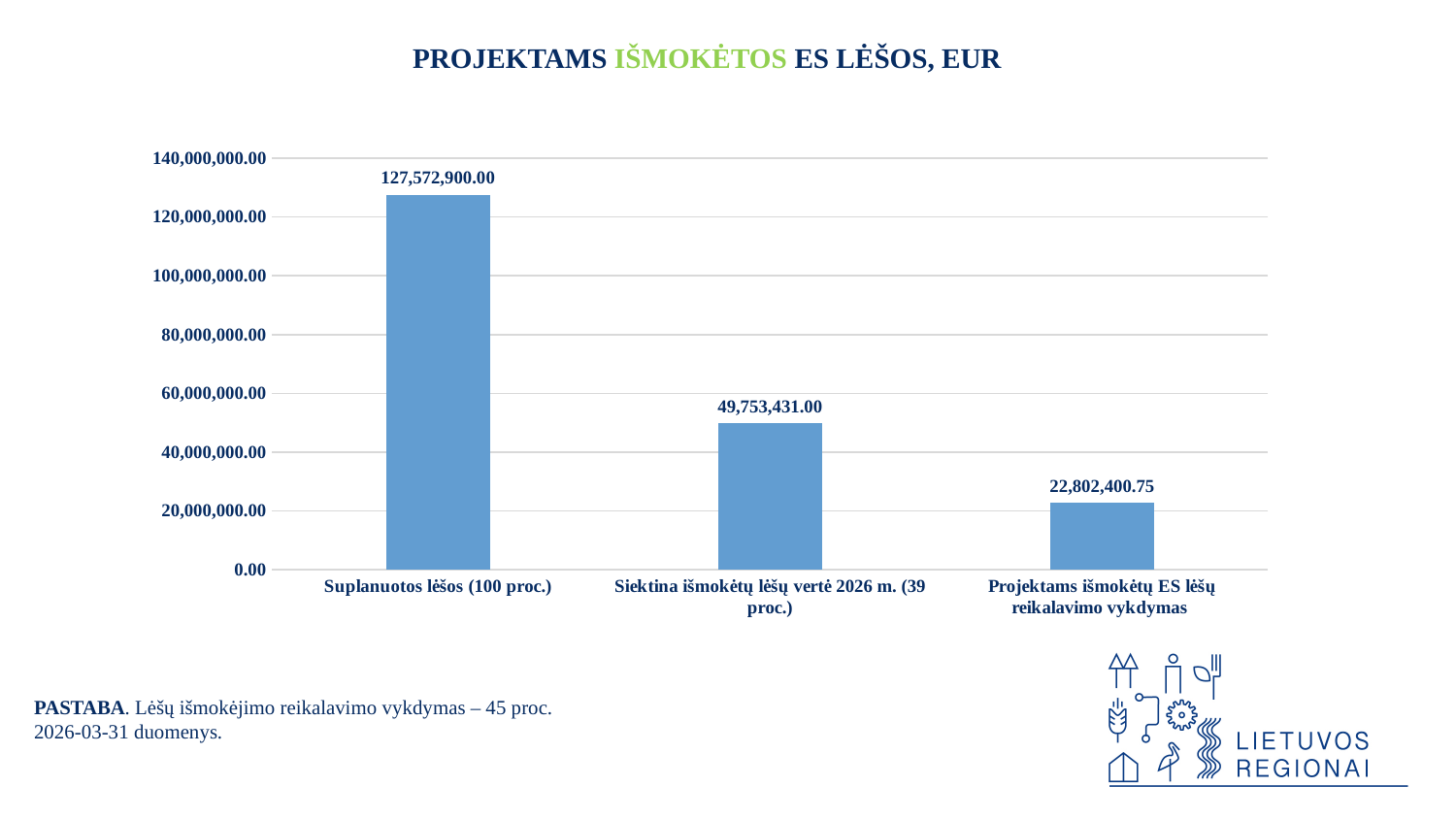
What is the difference between Suplanuotos lėšos (100 proc.) and Siektina išmokėtų lėšų vertė 2026 m. (39 proc.)? 77,819,469.00 Which category has the lowest value? Projektams išmokėtų ES lėšų reikalavimo vykdymas How many categories are shown in the chart? 3 What is the title of the chart? PROJEKTAMS IŠMOKĖTOS ES LĖŠOS, EUR Is the value for Siektina išmokėtų lėšų vertė 2026 m. (39 proc.) greater or less than 40,000,000.00? greater What is the value for Suplanuotos lėšos (100 proc.)? 127,572,900.00 Which category has the highest value? Suplanuotos lėšos (100 proc.) What is the value for Projektams išmokėtų ES lėšų reikalavimo vykdymas? 22,802,400.75 What is the difference between Siektina išmokėtų lėšų vertė 2026 m. (39 proc.) and Projektams išmokėtų ES lėšų reikalavimo vykdymas? 26,951,030.25 Which is larger: Siektina išmokėtų lėšų vertė 2026 m. (39 proc.) or Projektams išmokėtų ES lėšų reikalavimo vykdymas? Siektina išmokėtų lėšų vertė 2026 m. (39 proc.) What kind of chart is shown on the slide? bar chart What is the value for Siektina išmokėtų lėšų vertė 2026 m. (39 proc.)? 49,753,431.00